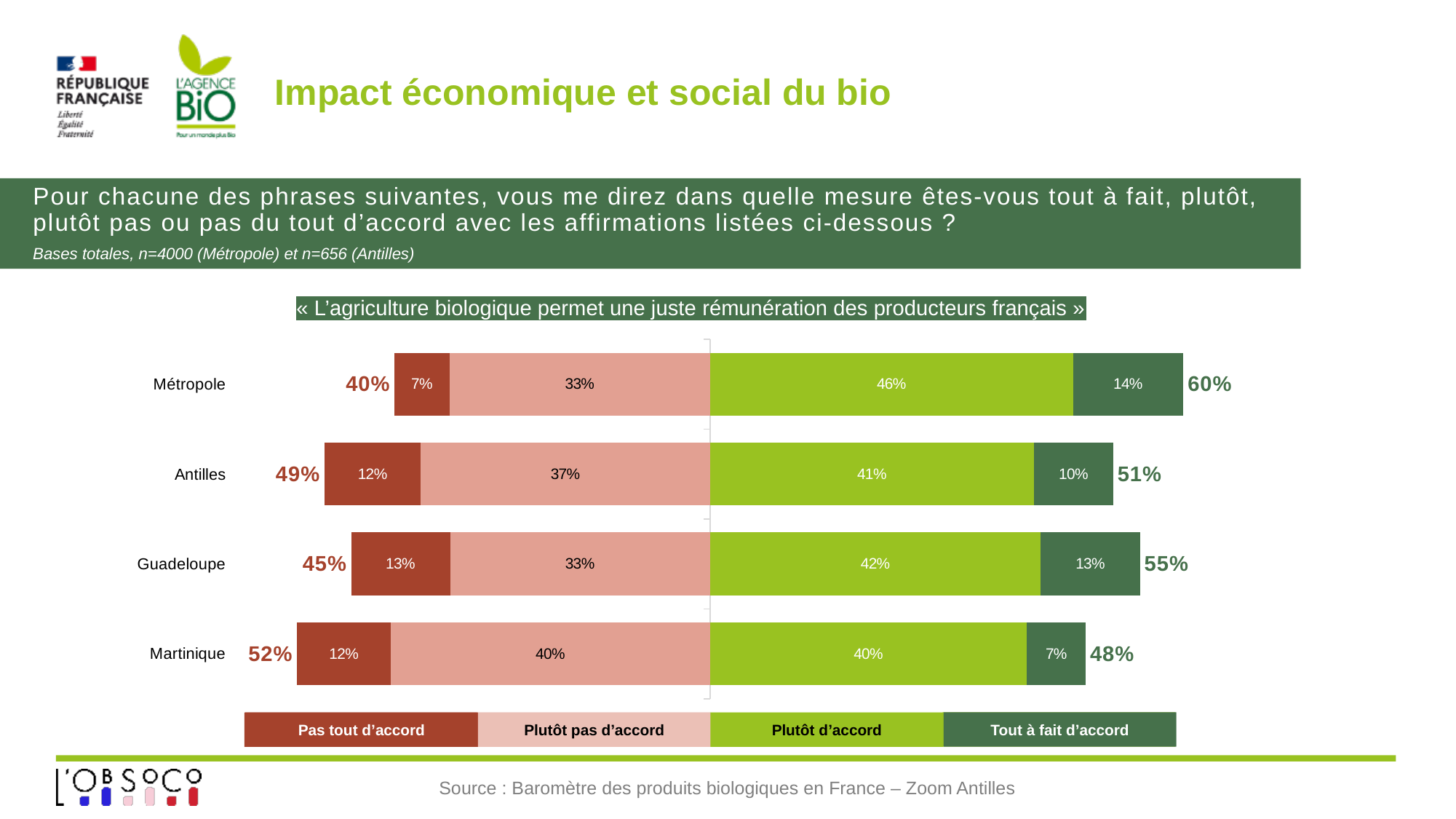
How many response categories does the legend list? 4 What statement is the chart about, as shown in the heading above the bars? « L'agriculture biologique permet une juste rémunération des producteurs français » What percentage of respondents in Antilles answered "Tout à fait d'accord"? 10% What type of chart is shown on the slide? Stacked bar chart How many regions are shown in the chart? 4 Which region has the highest "Tout à fait d'accord" percentage? Métropole What is the difference between the "Plutôt pas d'accord" percentages for Martinique and Métropole? 7 percentage points Which region has the lowest "Tout à fait d'accord" percentage? Martinique Which is larger: the "Plutôt d'accord" percentage for Antilles or for Guadeloupe? Guadeloupe What is the combined share of "Plutôt d'accord" and "Tout à fait d'accord" shown for Guadeloupe? 55% What percentage of respondents in Martinique answered "Pas tout d'accord"? 12% What percentage of respondents in Métropole answered "Plutôt d'accord"? 46%